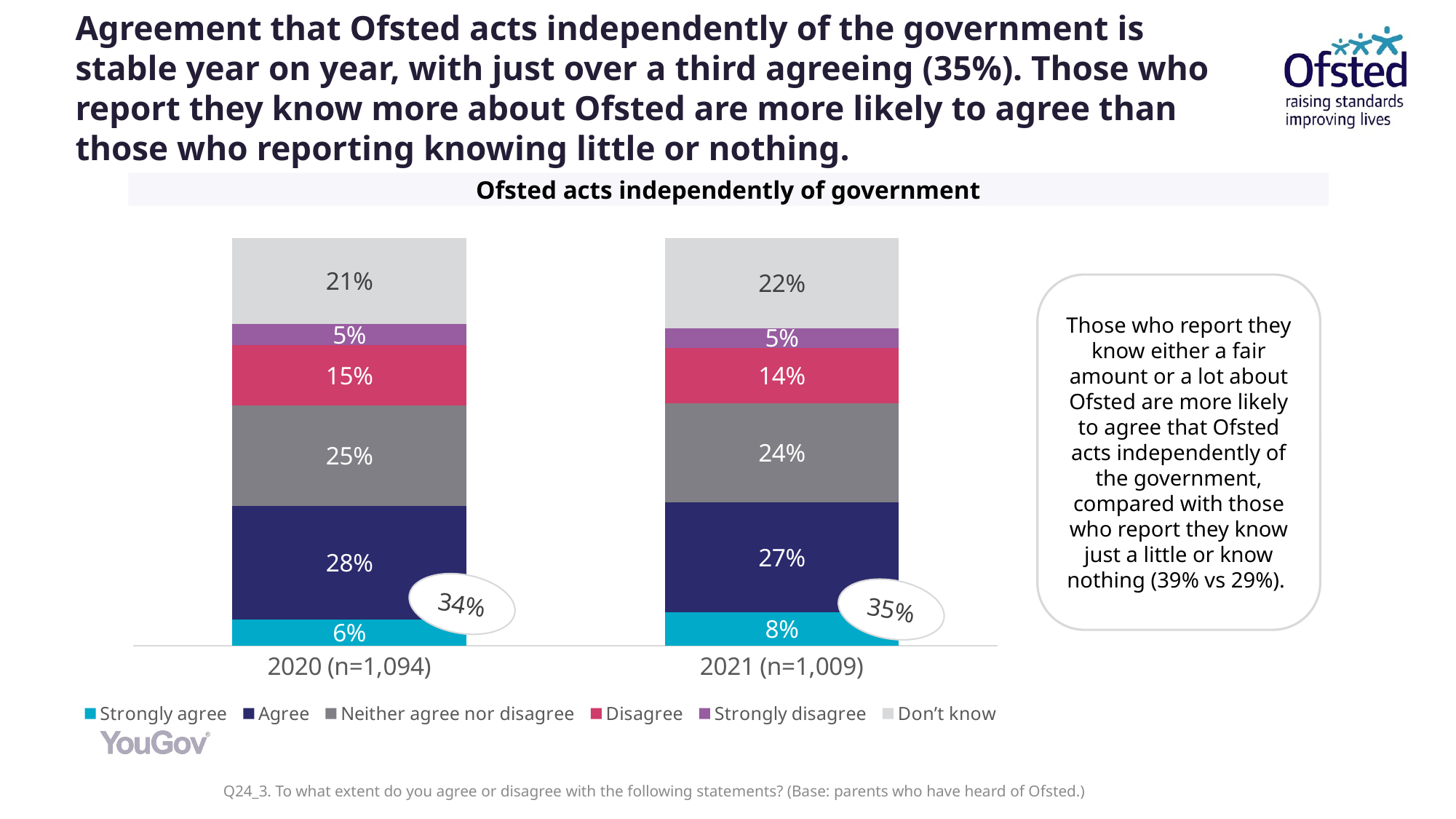
What percentage of respondents in 2020 said they 'Agree' that Ofsted acts independently of government? 28% Which year has the higher 'Strongly agree' percentage, 2020 or 2021? 2021 How many series does the legend list? 6 What is the 'Disagree' percentage for 2020? 15% What is the combined 'Strongly agree' and 'Agree' percentage shown for 2021? 35% What percentage of respondents in 2021 said they 'Strongly agree' that Ofsted acts independently of government? 8% What type of chart is shown on the slide? Stacked bar chart What is the 'Don't know' percentage for 2021? 22% Which response category has the largest share in the 2021 bar? Agree Which response category has the smallest share in the 2020 bar? Strongly disagree What is the difference between the 'Neither agree nor disagree' percentages for 2020 and 2021? 1% What is the sample size (n) shown for 2020? 1,094